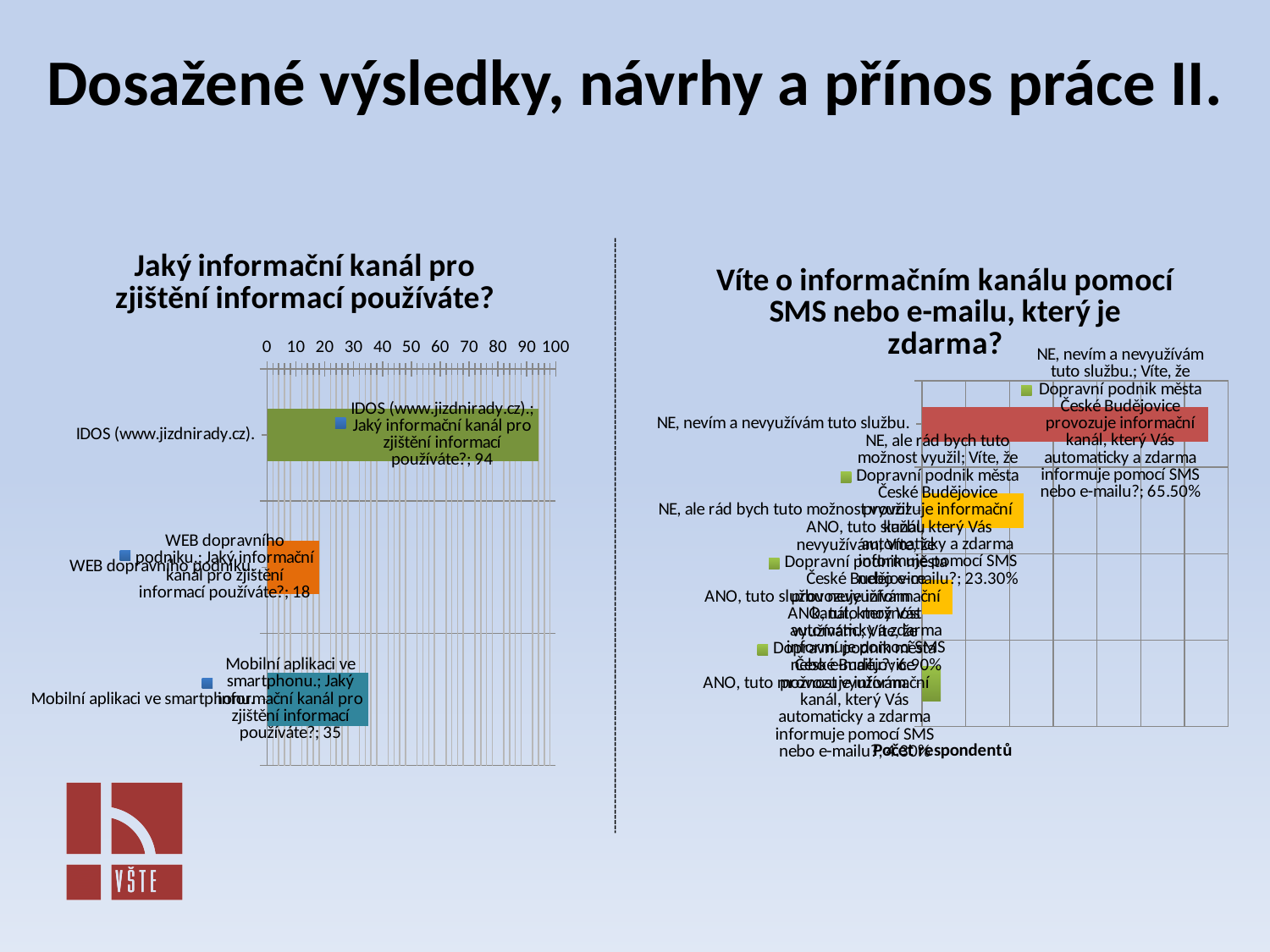
On the left chart 'Jaký informační kanál pro zjištění informací používáte?', what is the value for IDOS (www.jizdnirady.cz)? 94 What is the x-axis title of the right chart 'Víte o informačním kanálu pomocí SMS nebo e-mailu, který je zdarma?'? Počet respondentů On the left chart 'Jaký informační kanál pro zjištění informací používáte?', which category has the lowest value? WEB dopravního podniku On the right chart 'Víte o informačním kanálu pomocí SMS nebo e-mailu, který je zdarma?', which category has the highest value? NE, nevím a nevyužívám tuto službu. On the left chart 'Jaký informační kanál pro zjištění informací používáte?', what is the value for Mobilní aplikaci ve smartphonu? 35 On the left chart 'Jaký informační kanál pro zjištění informací používáte?', how many categories are plotted? 3 On the right chart 'Víte o informačním kanálu pomocí SMS nebo e-mailu, který je zdarma?', what is the value for 'NE, nevím a nevyužívám tuto službu.'? 65.50% On the left chart 'Jaký informační kanál pro zjištění informací používáte?', what is the difference between the values for IDOS (www.jizdnirady.cz) and Mobilní aplikaci ve smartphonu? 59 What type of chart is the left chart 'Jaký informační kanál pro zjištění informací používáte?'? Bar chart On the left chart 'Jaký informační kanál pro zjištění informací používáte?', what is the value for WEB dopravního podniku? 18 On the left chart 'Jaký informační kanál pro zjištění informací používáte?', which category has the highest value? IDOS (www.jizdnirady.cz) On the right chart 'Víte o informačním kanálu pomocí SMS nebo e-mailu, který je zdarma?', what is the value for 'NE, ale rád bych tuto možnost využil'? 23.30%